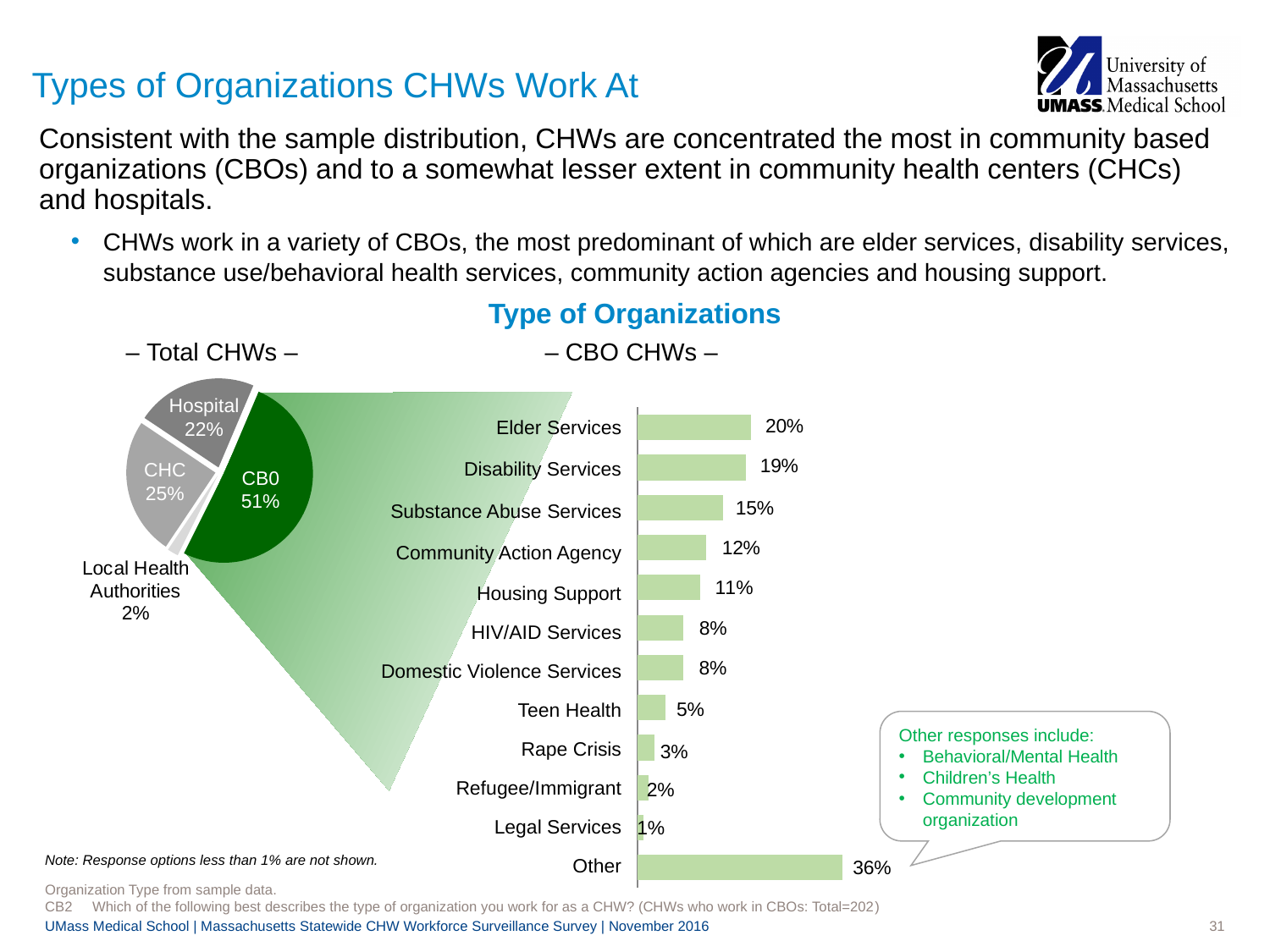
What kind of chart is the Total CHWs chart? Pie chart How many categories are shown in the CBO CHWs bar chart? 12 In the Total CHWs pie chart, what is the difference between the CHC share and the Hospital share? 3% In the Total CHWs pie chart, which organization type has the smallest share? Local Health Authorities In the CBO CHWs bar chart, what is the difference between Disability Services and Substance Abuse Services? 4% In the Total CHWs pie chart, which organization type has the largest share? CBO In the Total CHWs pie chart, what share of CHWs work at hospitals? 22% In the CBO CHWs bar chart, which is larger: Teen Health or Rape Crisis? Teen Health In the CBO CHWs bar chart, what is the value for Housing Support? 11% In the CBO CHWs bar chart, what is the value for Elder Services? 20% In the CBO CHWs bar chart, which category has the highest value? Other In the CBO CHWs bar chart, which category has the lowest value? Legal Services